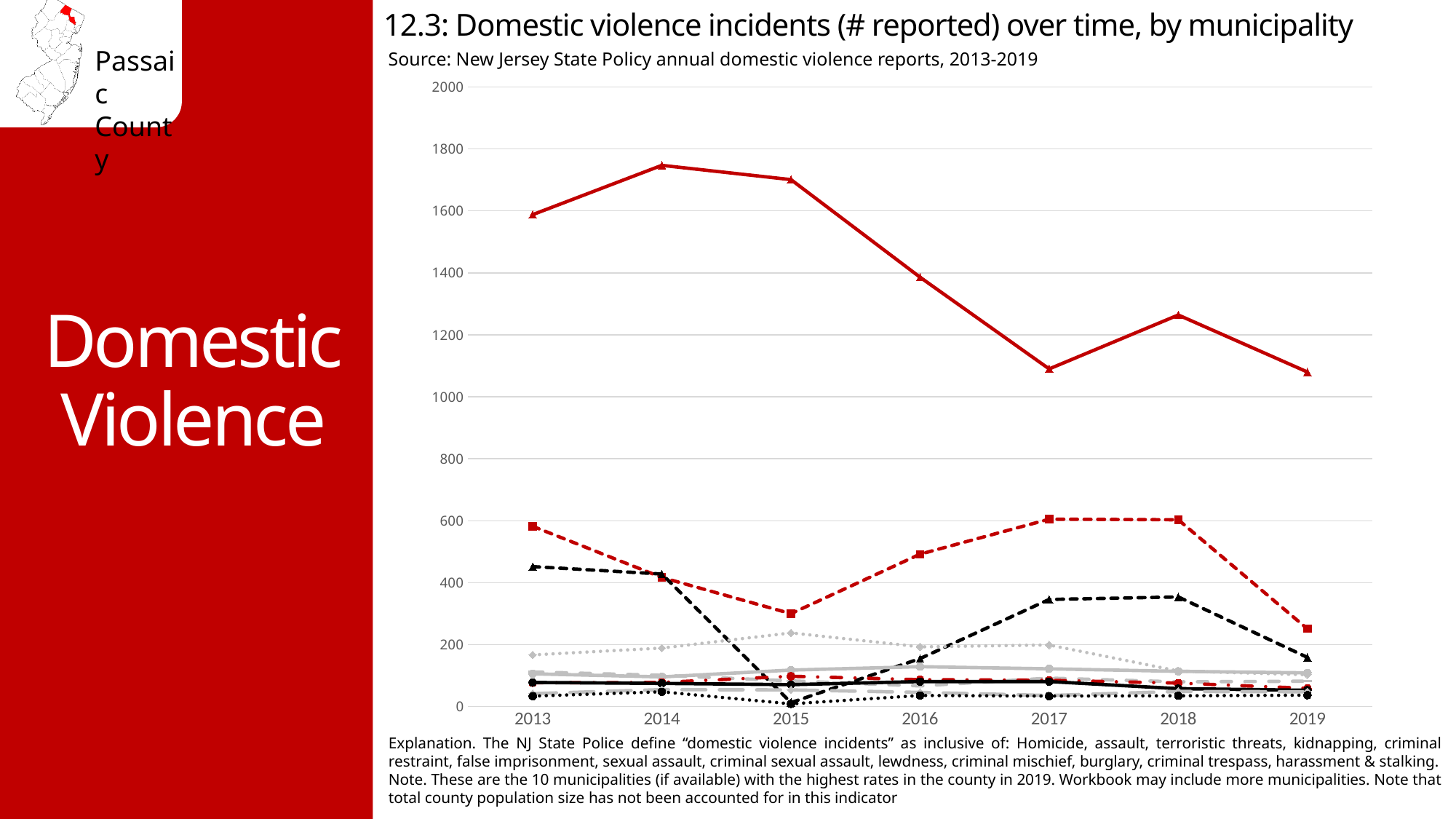
Is the value of the dashed red line with square markers in 2019 greater or less than 400? less In 2013, which is higher: the solid red line with triangle markers or the dashed red line with square markers? the solid red line with triangle markers In 2019, which is higher: the dashed red line with square markers or the dashed black line with triangle markers? the dashed red line with square markers Is the value of the top solid red line with triangle markers in 2016 greater or less than 1200? greater Does the top solid red line with triangle markers rise or fall between 2015 and 2017? fall Is the value of the top solid red line with triangle markers in 2019 greater or less than 1200? less What kind of chart is shown on the slide? line chart How many years are shown along the x axis of the chart? 7 What is the title of the chart on the slide? 12.3: Domestic violence incidents (# reported) over time, by municipality What is the highest value shown on the chart's y axis? 2000